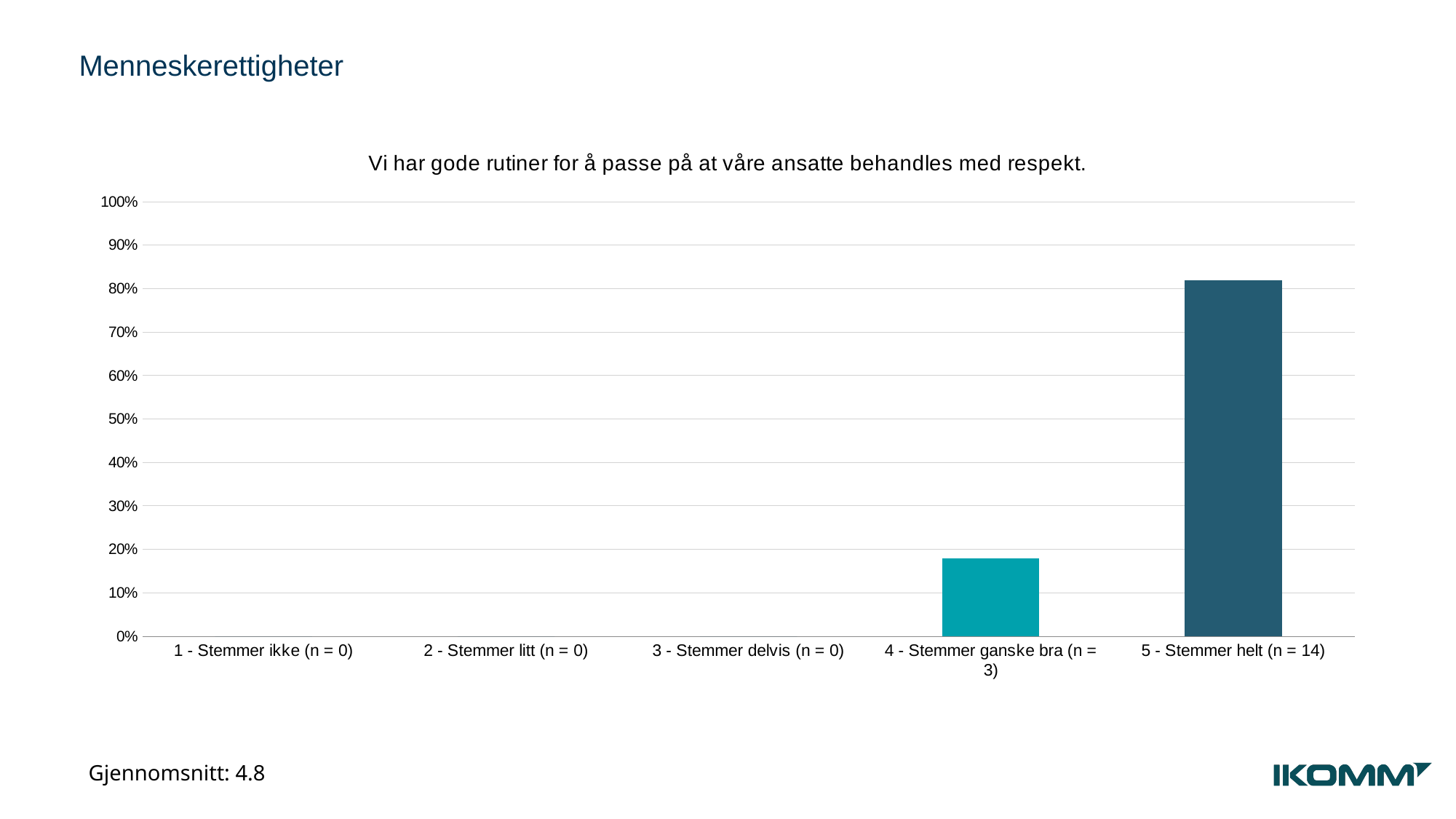
What is the title of the chart? Vi har gode rutiner for å passe på at våre ansatte behandles med respekt. How many respondents (n) chose "5 - Stemmer helt" according to the category label? 14 What average (Gjennomsnitt) is stated below the chart? 4.8 Which category has the highest bar in the chart? 5 - Stemmer helt (n = 14) What kind of chart is shown on the slide? bar chart Is the value for "4 - Stemmer ganske bra" greater or less than 10%? greater How many respondents (n) chose "4 - Stemmer ganske bra" according to the category label? 3 How many respondents (n) chose "1 - Stemmer ikke" according to the category label? 0 How many categories are shown on the x axis of the chart? 5 Is the value for "5 - Stemmer helt" greater or less than 70%? greater Which is larger, the value for "4 - Stemmer ganske bra" or the value for "5 - Stemmer helt"? 5 - Stemmer helt Is the value for "4 - Stemmer ganske bra" greater or less than 30%? less